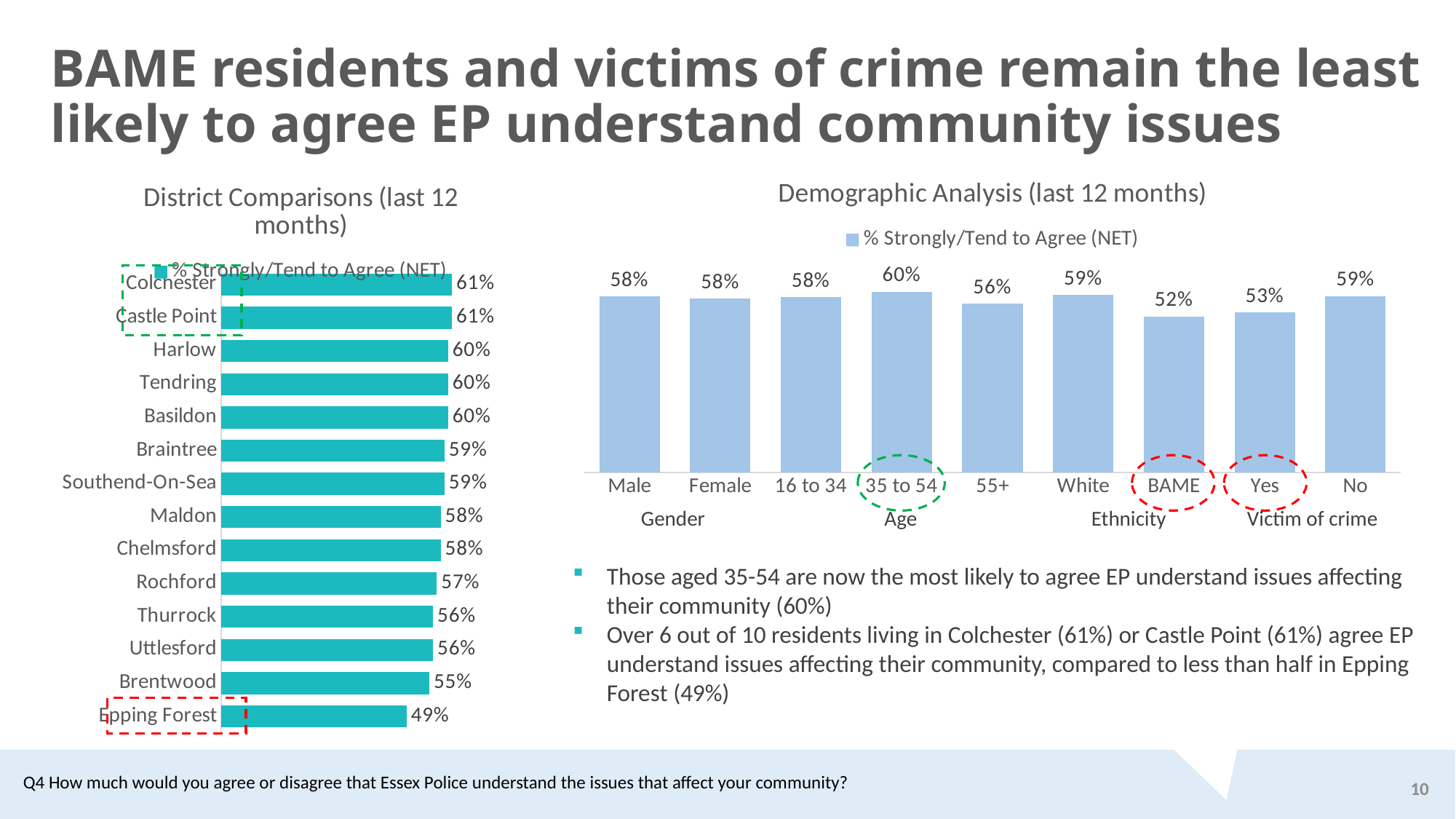
In the District Comparisons chart, what is the difference between Colchester and Epping Forest? 12 percentage points In the District Comparisons chart, which is larger, Brentwood or Maldon? Maldon In the Demographic Analysis chart, what is the value for 35 to 54? 60% In the District Comparisons chart, how many districts are shown? 14 In the Demographic Analysis chart, what is the value for BAME? 52% What type of chart is the Demographic Analysis chart? Bar chart In the Demographic Analysis chart, what is the difference between White and BAME? 7 percentage points In the Demographic Analysis chart, how many categories are shown on the x axis? 9 In the District Comparisons chart, what is the value for Rochford? 57% In the District Comparisons chart, which district has the lowest value? Epping Forest In the Demographic Analysis chart, which category has the lowest value? BAME In the District Comparisons chart, what is the value for Epping Forest? 49%